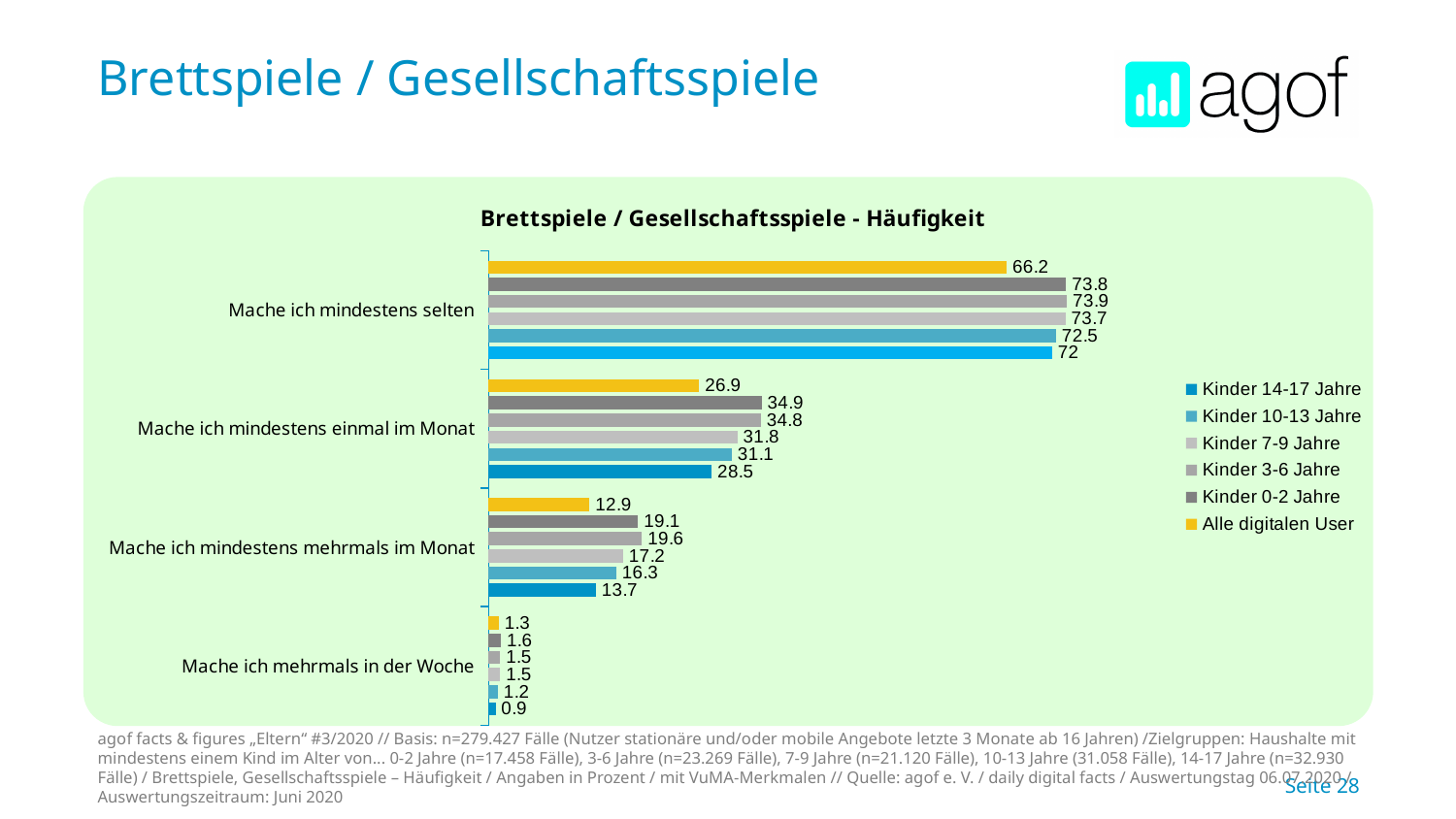
What is the title of the chart? Brettspiele / Gesellschaftsspiele - Häufigkeit What is the value for Alle digitalen User in the category 'Mache ich mindestens selten'? 66.2 Which series has the highest value in the category 'Mache ich mindestens mehrmals im Monat'? Kinder 3-6 Jahre What type of chart is shown on the slide? bar chart How many series does the legend list? 6 What is the value for Kinder 3-6 Jahre in the category 'Mache ich mindestens mehrmals im Monat'? 19.6 What is the difference between Kinder 0-2 Jahre and Alle digitalen User in the category 'Mache ich mindestens einmal im Monat'? 8 What is the value for Kinder 10-13 Jahre in the category 'Mache ich mehrmals in der Woche'? 1.2 What is the value for Kinder 14-17 Jahre in the category 'Mache ich mindestens einmal im Monat'? 28.5 How many categories are shown on the chart? 4 Which series has the lowest value in the category 'Mache ich mehrmals in der Woche'? Kinder 14-17 Jahre In the category 'Mache ich mindestens mehrmals im Monat', which is larger: Kinder 7-9 Jahre or Kinder 14-17 Jahre? Kinder 7-9 Jahre